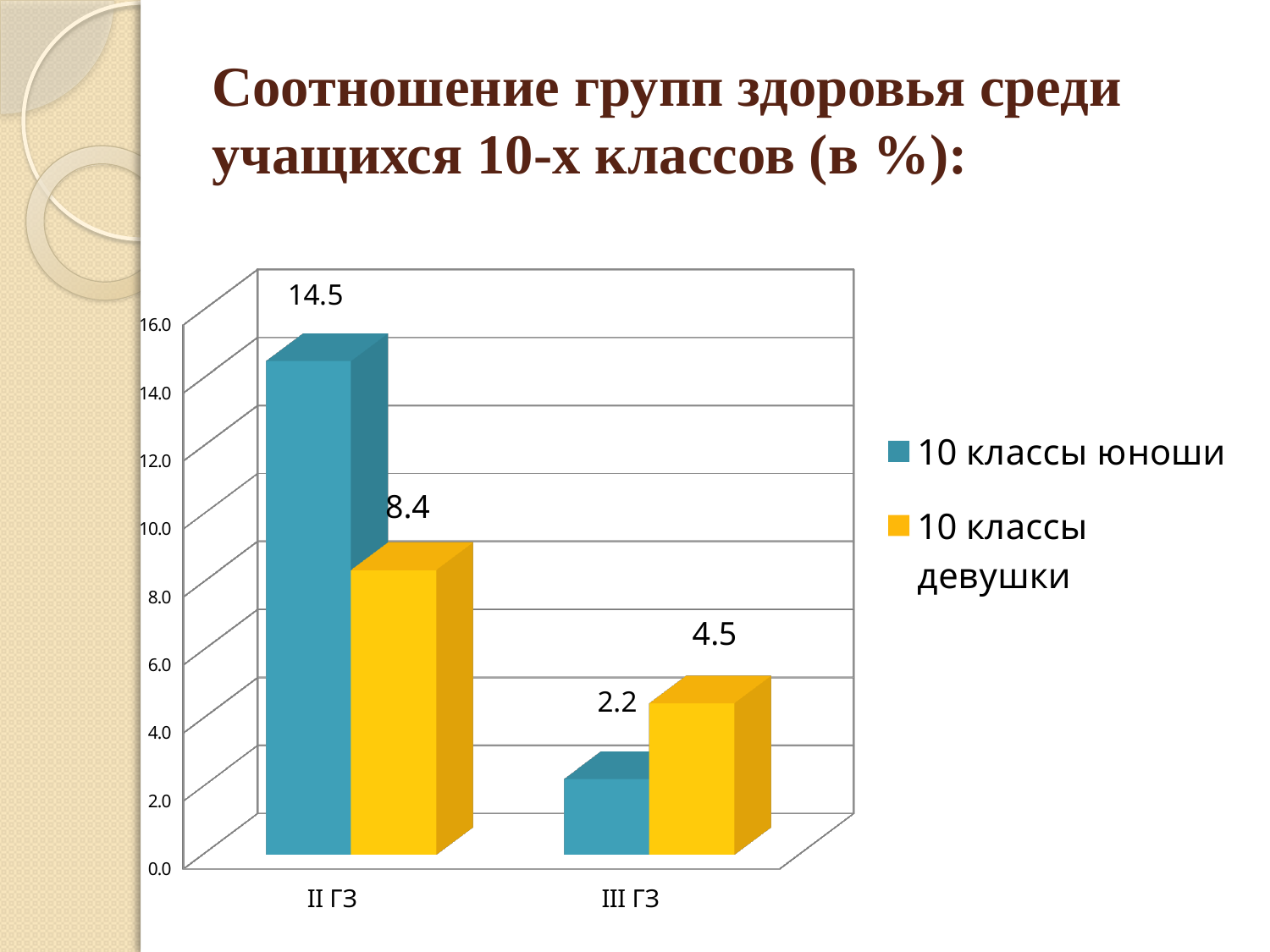
What is the value for 10 классы девушки in the III ГЗ category? 4.5 What is the value for 10 классы девушки in the II ГЗ category? 8.4 What colour represents the 10 классы девушки series? Yellow How many series does the legend list? 2 In the III ГЗ category, which series has the larger value: 10 классы юноши or 10 классы девушки? 10 классы девушки Which category has the highest value for 10 классы юноши? II ГЗ What kind of chart is shown on the slide? Bar chart How many categories are shown on the x axis? 2 Which category has the lowest value for 10 классы девушки? III ГЗ What is the difference between the 10 классы юноши and 10 классы девушки values in the II ГЗ category? 6.1 What is the value for 10 классы юноши in the II ГЗ category? 14.5 What is the value for 10 классы юноши in the III ГЗ category? 2.2